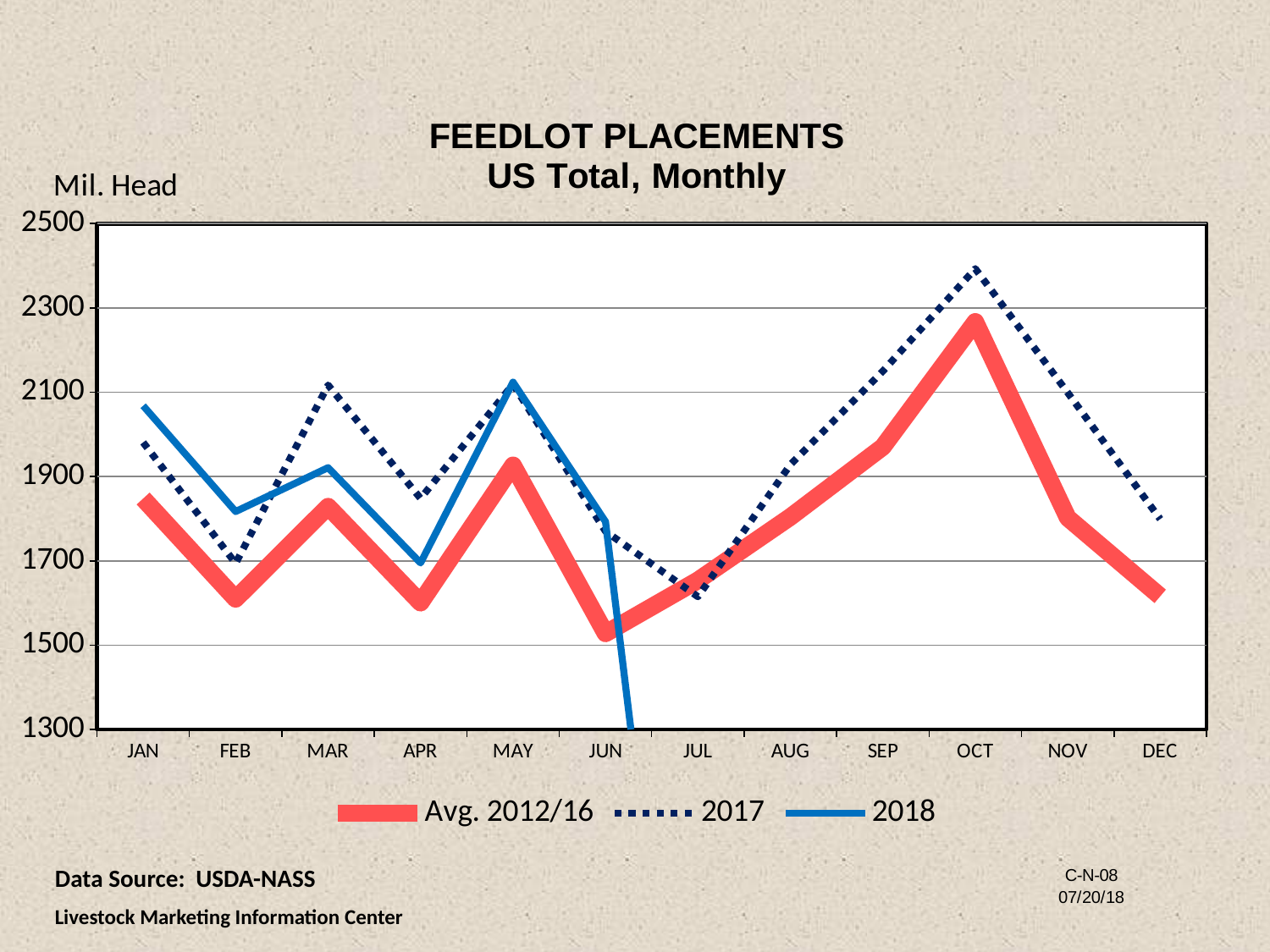
Is the Avg. 2012/16 value for DEC greater or less than 1700? less What kind of chart is shown on the slide? line chart Is the 2018 value for JAN greater or less than 1900? greater Is the 2017 value for OCT greater or less than 2300? greater What label is shown on the vertical axis of the chart? Mil. Head How many months are shown along the x axis? 12 In which month does the 2017 series reach its highest value? OCT In which month does the Avg. 2012/16 series reach its lowest value? JUN Does the Avg. 2012/16 series rise or fall from OCT to DEC? fall In MAR, which series has the higher value, 2017 or 2018? 2017 How many series does the legend list? 3 In which month does the 2017 series reach its lowest value? JUL